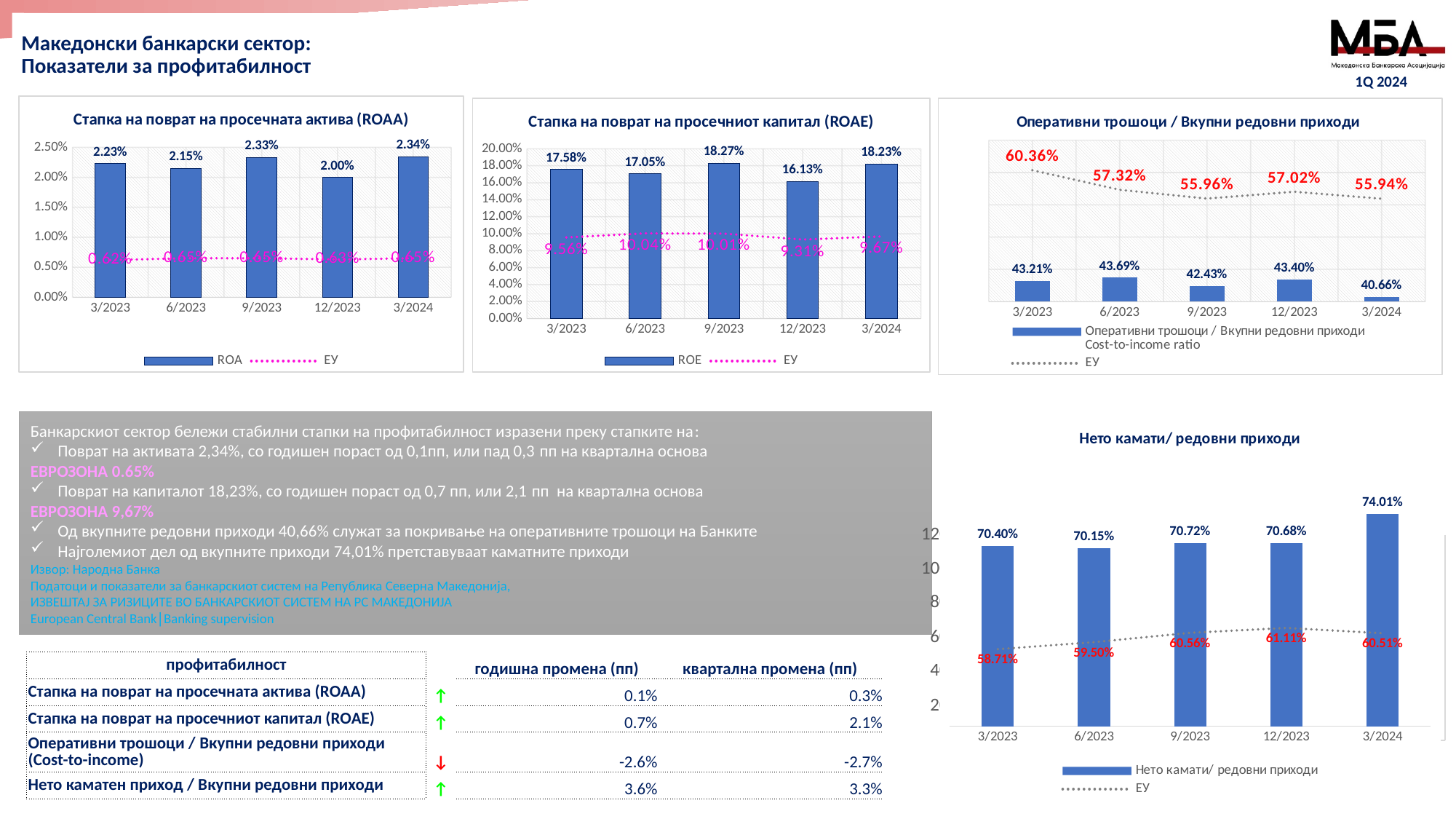
How many periods are shown on the x axis of the chart titled Нето камати/ редовни приходи? 5 In the ROAE chart (Стапка на поврат на просечниот капитал), what is the ROE value for 9/2023? 18.27% In the ROAE chart, which period has the highest ROE value? 9/2023 In the ROAA chart, what is the difference between the ROA values for 3/2024 and 12/2023? 0.34% In the ROAE chart, what is the ЕУ value for 6/2023? 10.04% In the ROAA chart (Стапка на поврат на просечната актива), what is the ROA value for 3/2024? 2.34% In the chart titled Оперативни трошоци / Вкупни редовни приходи, what is the bar value for 3/2024? 40.66% In the ROAA chart, which period has the lowest ROA value? 12/2023 In the chart titled Оперативни трошоци / Вкупни редовни приходи, what is the ЕУ value for 3/2023? 60.36% In the chart titled Нето камати/ редовни приходи, what is the difference between the bar values for 3/2024 and 12/2023? 3.33% In the chart titled Оперативни трошоци / Вкупни редовни приходи, is the bar value for 6/2023 larger or smaller than the bar value for 9/2023? larger In the chart titled Нето камати/ редовни приходи, what is the bar value for 3/2024? 74.01%